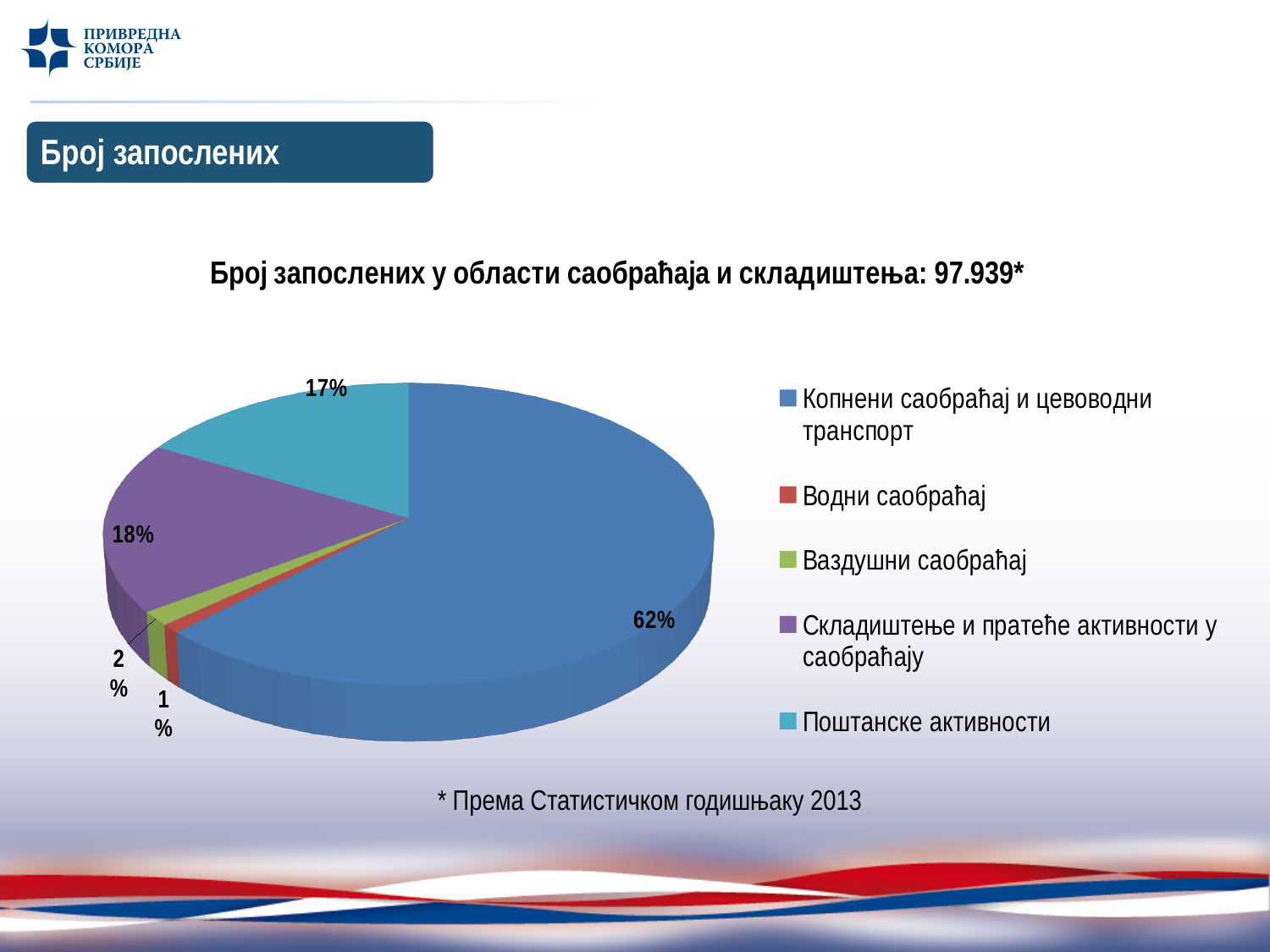
What share of the pie does Складиштење и пратеће активности у саобраћају hold? 18% How many entries does the legend list? 5 How many categories does the pie chart have? 5 What is the difference in percentage points between the Складиштење и пратеће активности у саобраћају slice and the Поштанске активности slice? 1 What total number of employees is stated in the chart title? 97.939 What share of the pie does Ваздушни саобраћај hold? 2% What kind of chart is shown on the slide? pie chart What share of the pie does Копнени саобраћај и цевоводни транспорт hold? 62% What is the difference in percentage points between the Копнени саобраћај и цевоводни транспорт slice and the Складиштење и пратеће активности у саобраћају slice? 44 Which is larger, the slice for Складиштење и пратеће активности у саобраћају or the slice for Поштанске активности? Складиштење и пратеће активности у саобраћају Which category has the largest slice of the pie? Копнени саобраћај и цевоводни транспорт